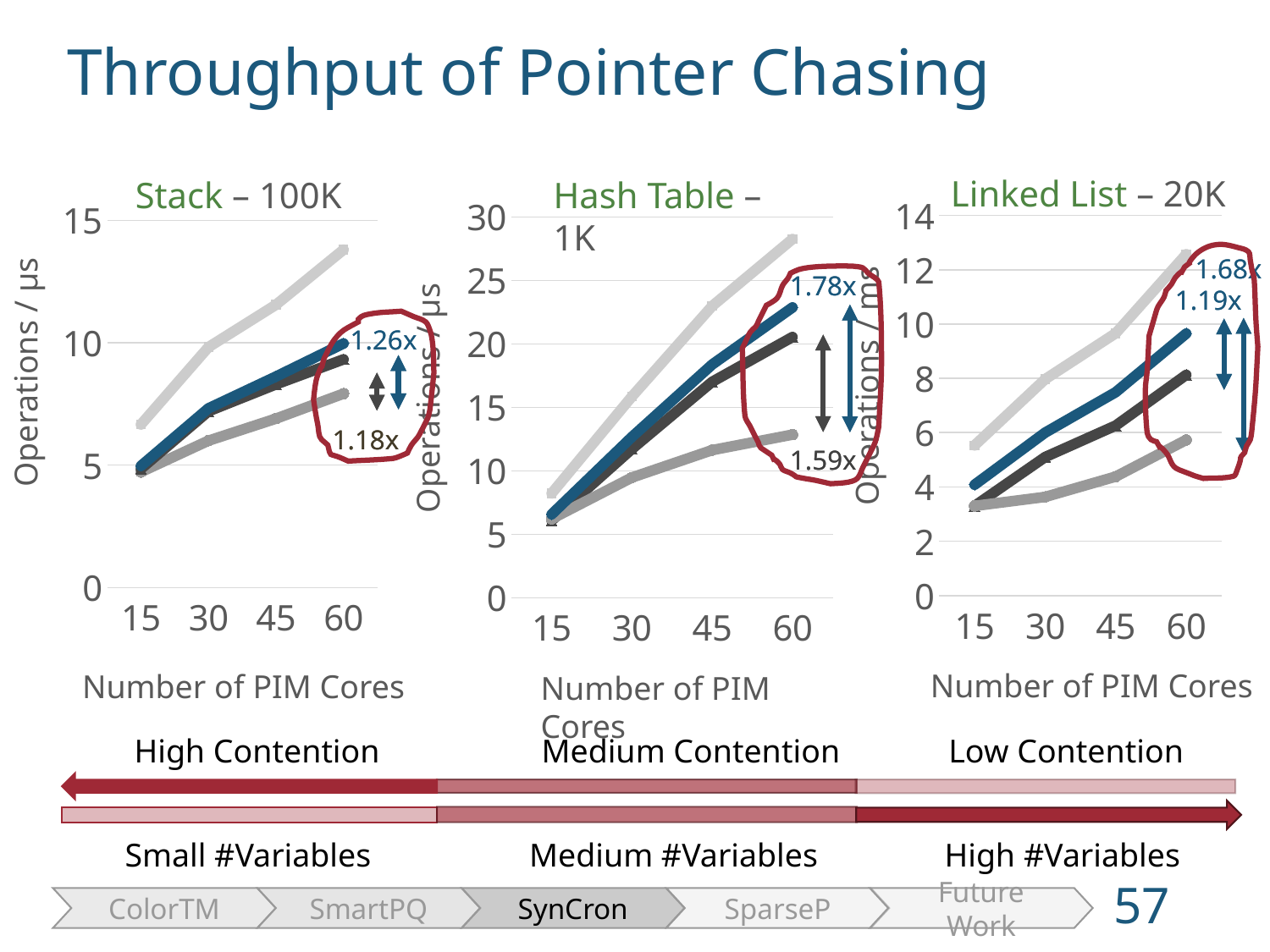
On the Linked List – 20K chart, which line is highest at 60 PIM cores? the light gray line On the Hash Table – 1K chart, is the value of the light gray line at 60 PIM cores greater or less than 25? greater What kind of chart is the Stack – 100K chart? line chart On the Hash Table – 1K chart, is the value of the lowest line at 60 PIM cores greater or less than 15? less On the Stack – 100K chart, is the value of the light gray line at 60 PIM cores greater or less than 10? greater On the Hash Table – 1K chart, do the lines rise or fall as the number of PIM cores increases from 15 to 60? rise What is the x-axis label of the Stack – 100K chart? Number of PIM Cores How many values of Number of PIM Cores are plotted on the x axis of the Hash Table – 1K chart? 4 On the Stack – 100K chart, do the lines rise or fall as the number of PIM cores increases? rise What speedup annotation is printed in blue on the Hash Table – 1K chart? 1.78x On the Linked List – 20K chart, do the lines rise or fall along the x axis? rise